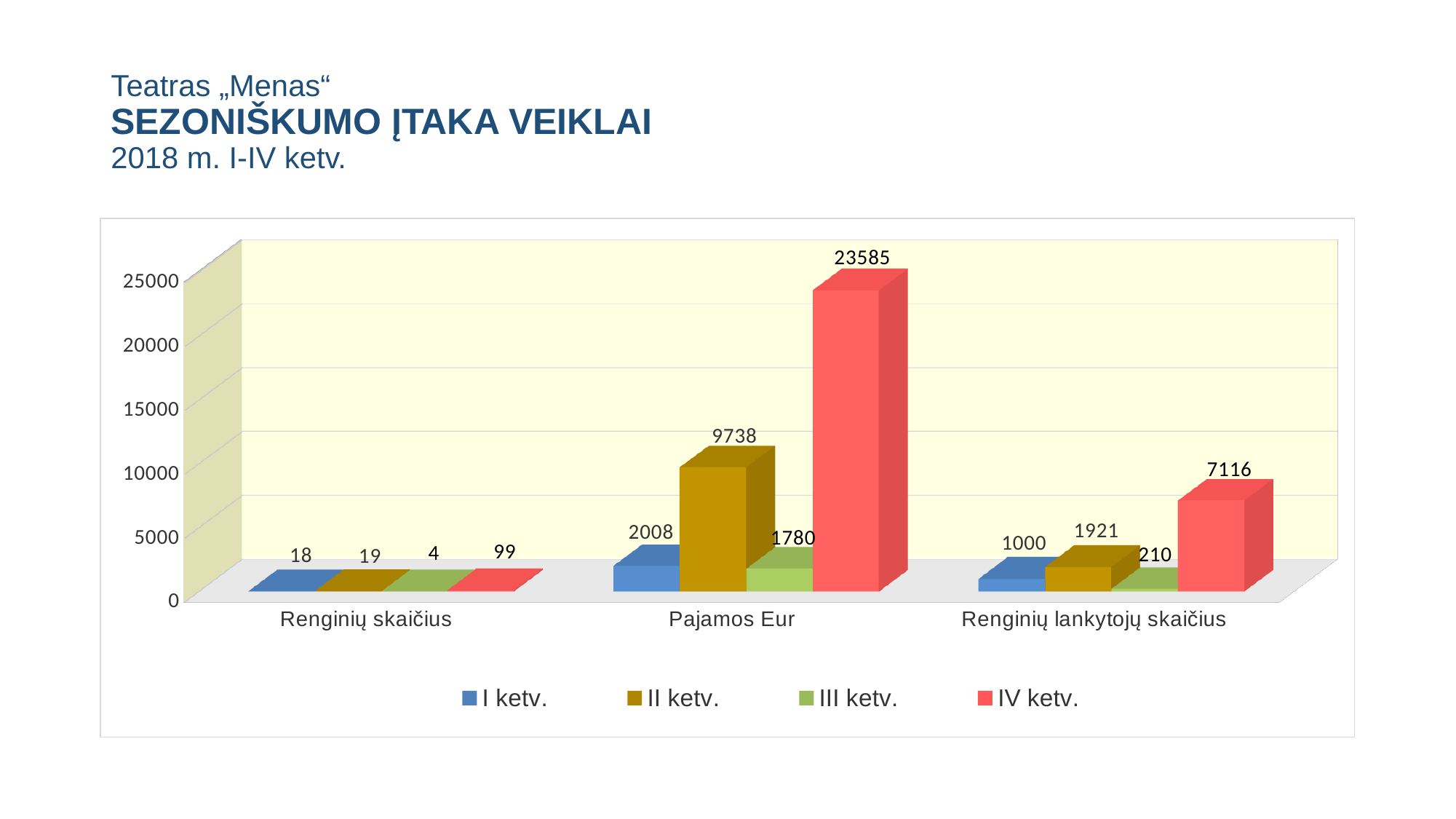
What is the value for I ketv. in the Pajamos Eur category? 2008 What kind of chart is shown on the slide? Bar chart What is the value for II ketv. in the Renginių lankytojų skaičius category? 1921 How many series does the legend list? 4 What is the value for III ketv. in the Renginių skaičius category? 4 Which is larger in the Renginių skaičius category: I ketv. or II ketv.? II ketv. What is the value for IV ketv. in the Pajamos Eur category? 23585 How many categories are shown on the x axis? 3 Is the value for IV ketv. in the Renginių lankytojų skaičius category greater or less than 5000? greater Which quarter has the highest value in the Renginių lankytojų skaičius category? IV ketv. What is the difference between the IV ketv. and II ketv. values in the Pajamos Eur category? 13847 Which quarter has the lowest value in the Pajamos Eur category? III ketv.